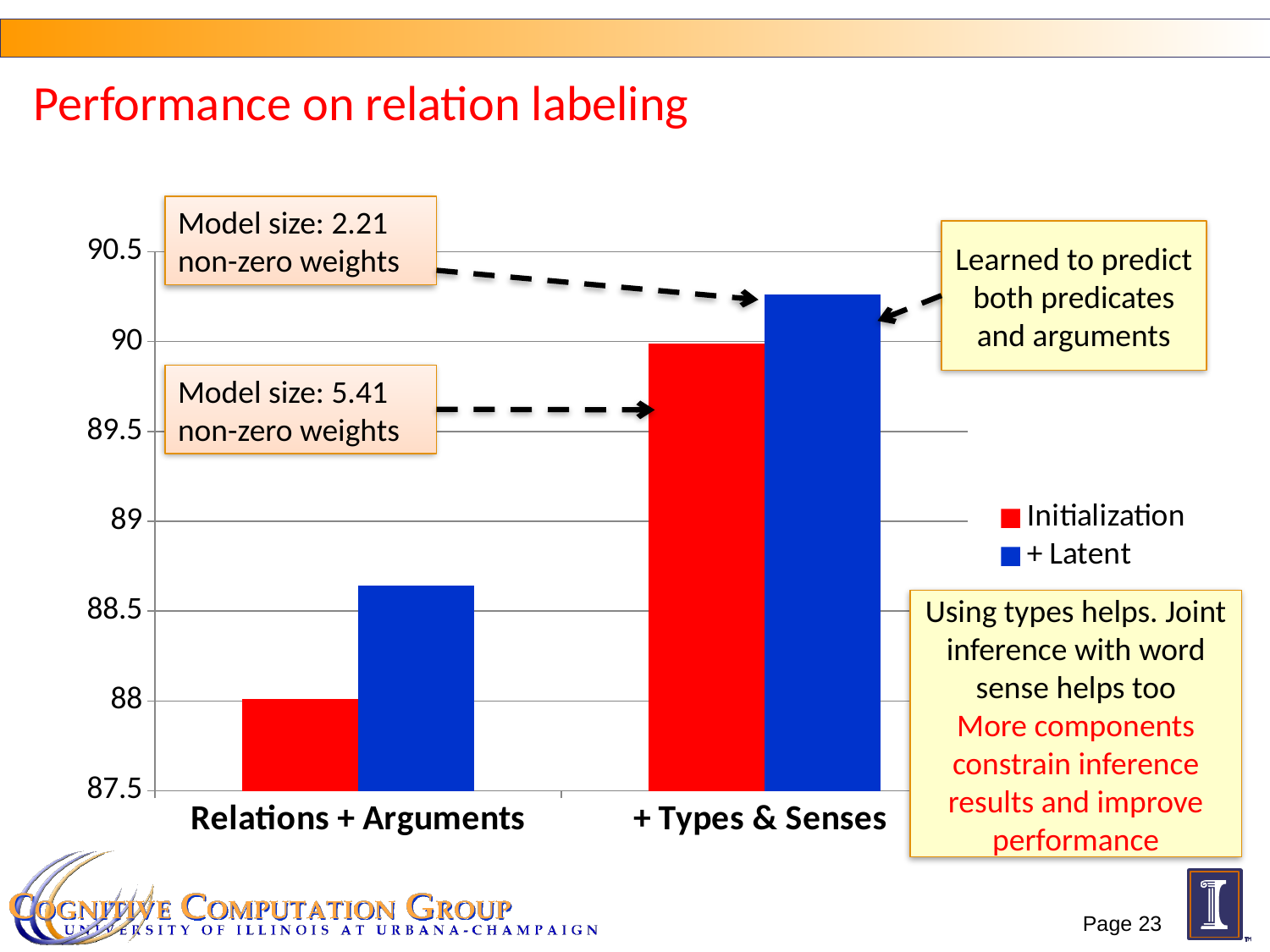
What are the two series named in the chart's legend? Initialization and + Latent Is the + Latent value for Relations + Arguments greater or less than 88.5? greater Which series is shown in blue in the chart? + Latent Which bar in the chart is the shortest? Initialization for Relations + Arguments Which bar in the chart is the tallest? + Latent for + Types & Senses Do the values for both series rise or fall from Relations + Arguments to + Types & Senses? rise For + Types & Senses, which series has the larger value, Initialization or + Latent? + Latent Is the + Latent value for + Types & Senses greater or less than 90? greater How many series does the chart's legend list? 2 For Relations + Arguments, which series has the larger value, Initialization or + Latent? + Latent How many categories are shown on the x axis of the chart? 2 What kind of chart is shown on the slide? bar chart